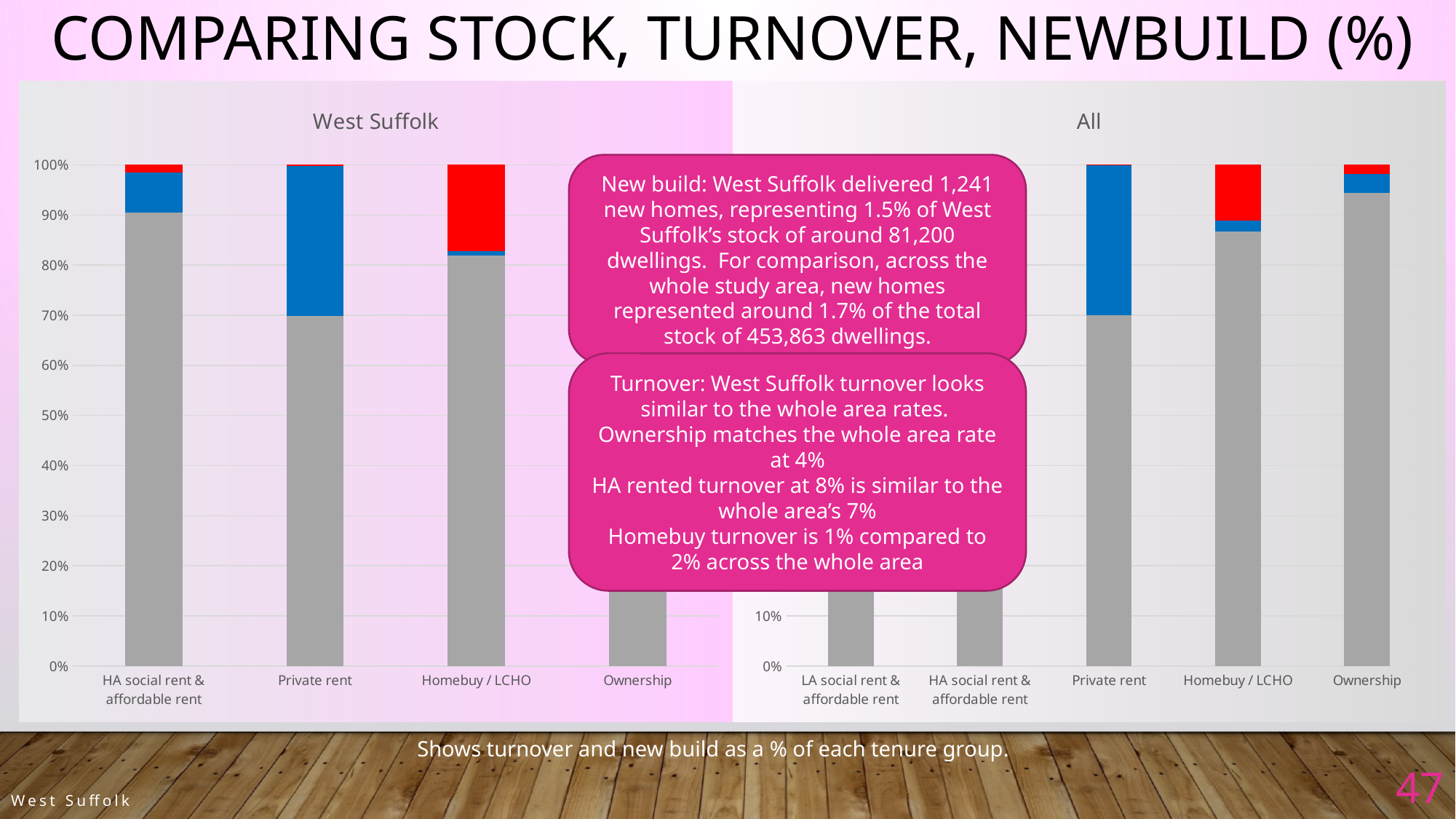
In the West Suffolk chart, which has the larger blue segment: Private rent or HA social rent & affordable rent? Private rent In the West Suffolk chart, which has the larger red segment: Homebuy / LCHO or HA social rent & affordable rent? Homebuy / LCHO How many tenure categories are shown on the x axis of the West Suffolk chart? 4 In the All chart, is the top of the grey segment for Homebuy / LCHO greater or less than 80%? greater In the West Suffolk chart, is the top of the grey segment for Homebuy / LCHO greater or less than 80%? greater In the All chart, is the top of the grey segment for Ownership greater or less than 90%? greater How many tenure categories are shown on the x axis of the All chart? 5 In the All chart, which category has the largest blue segment? Private rent What is the title of the chart on the right of the slide? All What kind of chart is the West Suffolk chart? Stacked bar chart In the All chart, which category has the largest red segment? Homebuy / LCHO